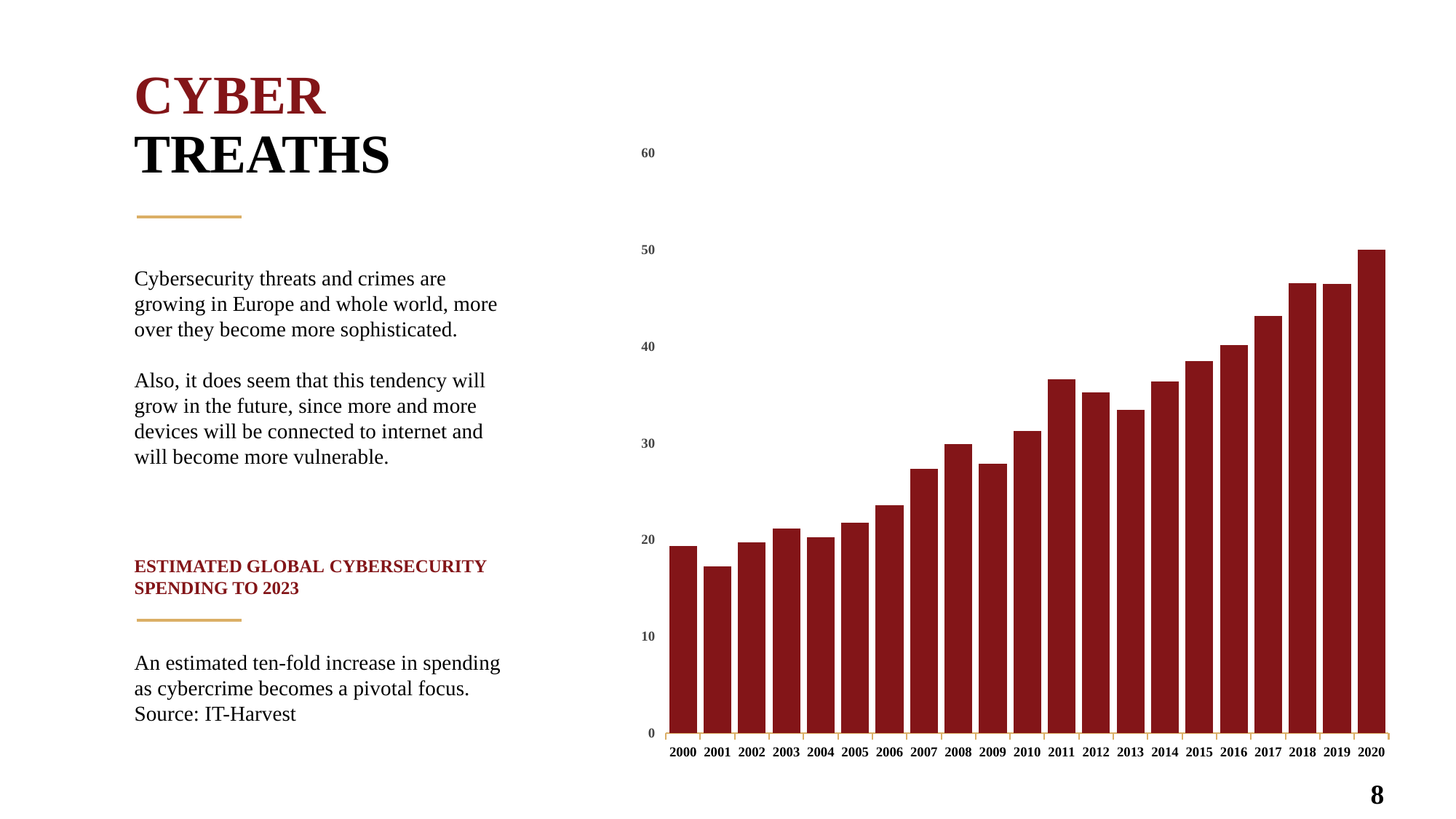
Which year has the lowest bar on the chart? 2001 Overall, do the values rise or fall from 2000 to 2020? rise What is the title given for the chart on the slide? ESTIMATED GLOBAL CYBERSECURITY SPENDING TO 2023 Which year has the highest bar on the chart? 2020 Is the value for 2001 greater or less than 20? less Is the value for 2011 greater or less than 40? less Which year has the larger value, 2006 or 2010? 2010 Is the value for 2013 greater or less than 30? greater How many years (bars) are plotted on the chart? 21 Which year has the larger value, 2011 or 2013? 2011 What kind of chart is shown on the slide? bar chart